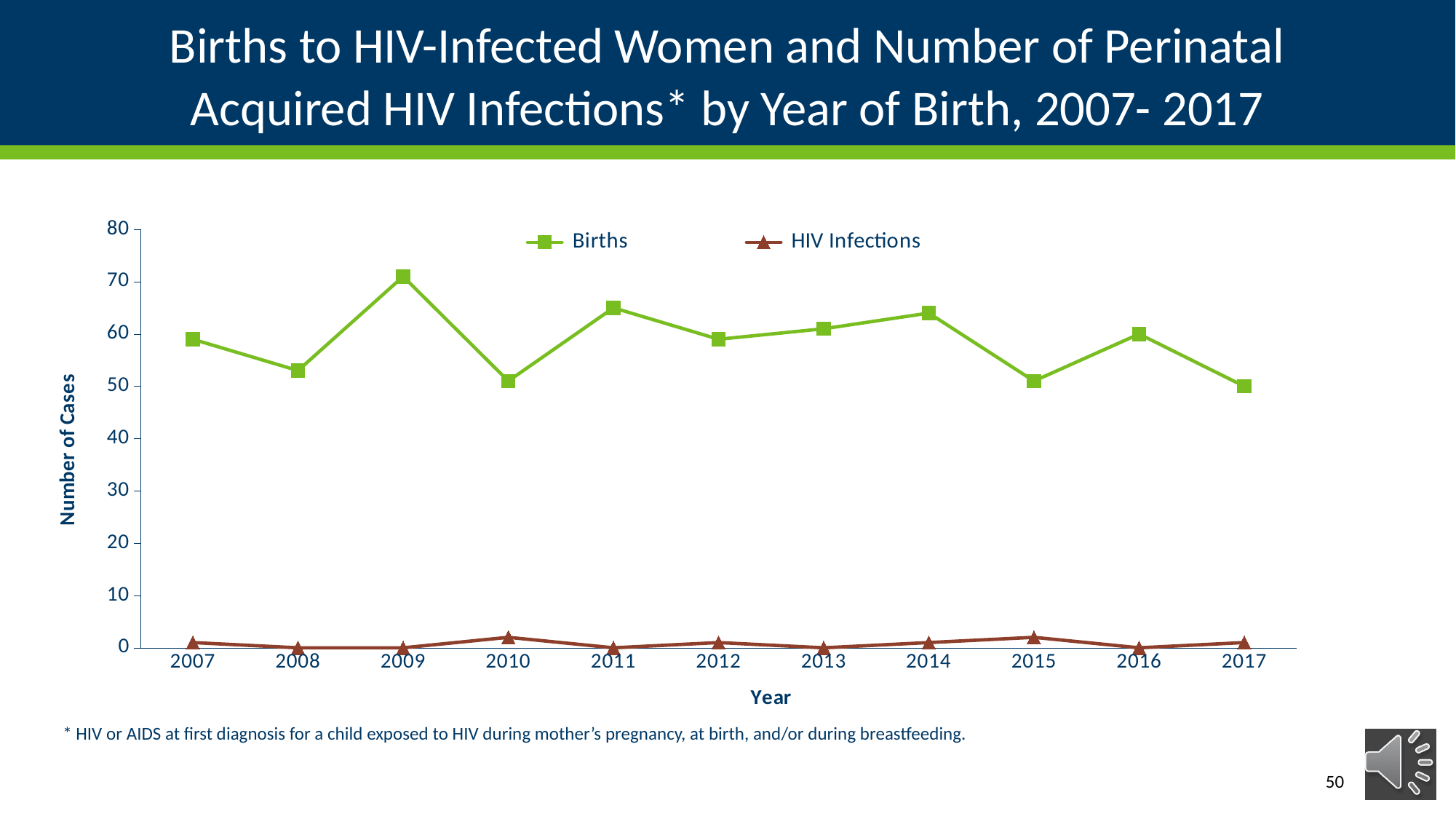
Is the value for Births in 2010 greater or less than 60? less Do Births rise or fall from 2014 to 2015? fall Is the value for Births in 2015 greater or less than 60? less Which is larger, the number of Births in 2009 or in 2010? 2009 In which year is the number of Births highest? 2009 What is the title of the y axis? Number of Cases What kind of chart is shown on the slide? line chart Is the value for Births in 2009 greater or less than 60? greater What is the number of HIV Infections in 2008? 0 How many years are plotted along the x axis? 11 How many series does the legend list? 2